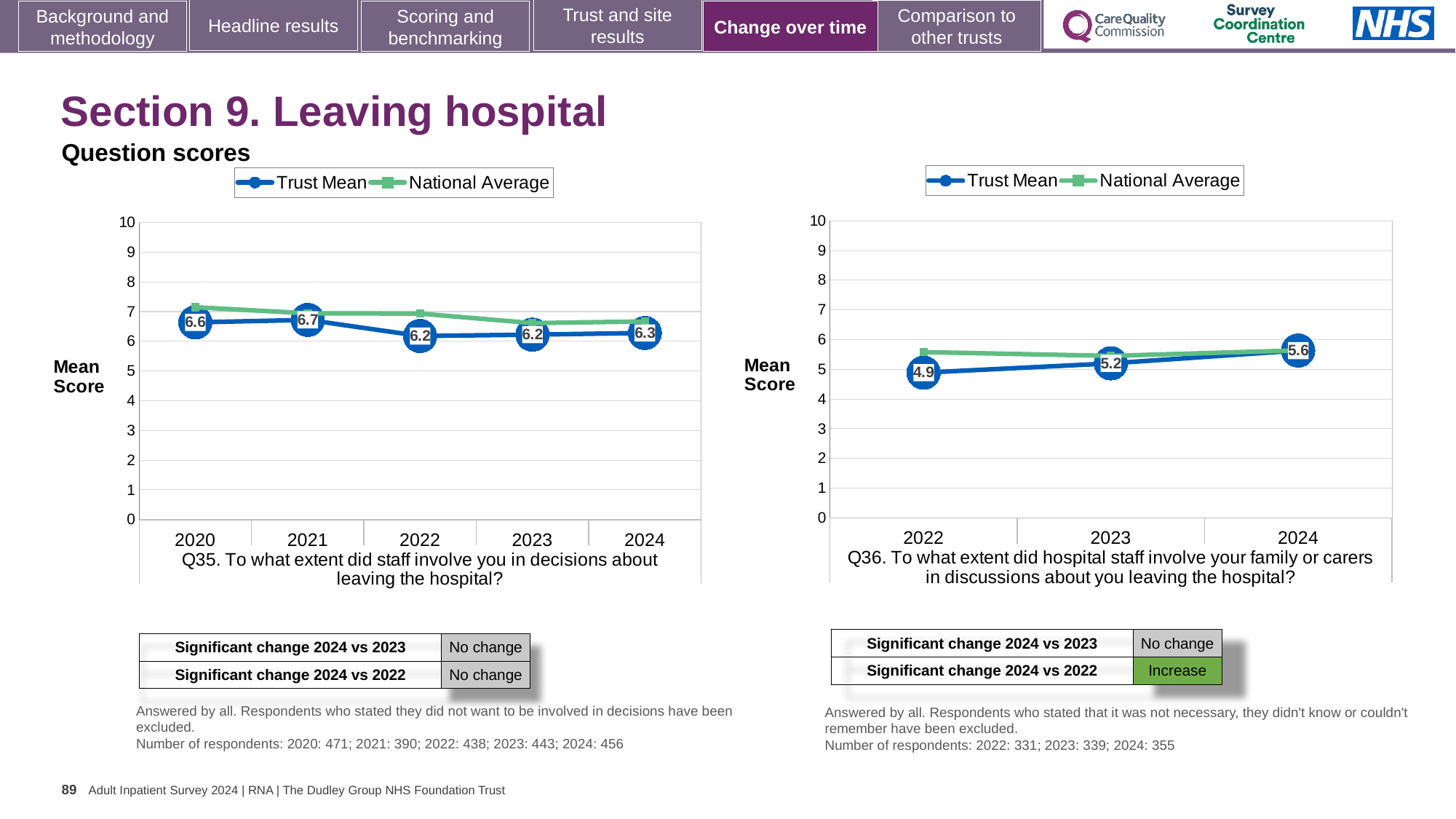
In the Q35 chart on the left, what is the Trust Mean score for 2021? 6.7 In the Q35 chart on the left, what is the Trust Mean score for 2024? 6.3 How many series does the legend of the Q35 chart on the left list? 2 In the Q35 chart on the left, is the National Average for 2020 greater or less than 7? greater In the Q35 chart on the left, what is the difference between the Trust Mean scores for 2021 and 2022? 0.5 What kind of chart is the Q36 chart on the right? Line chart In the Q36 chart on the right, what is the difference between the Trust Mean scores for 2024 and 2022? 0.7 In the Q35 chart on the left, which year has the highest Trust Mean score? 2021 In the Q36 chart on the right, what is the Trust Mean score for 2022? 4.9 In the Q36 chart on the right, what is the Trust Mean score for 2024? 5.6 How many years are plotted on the x axis of the Q36 chart on the right? 3 In the Q36 chart on the right, which year has the lowest Trust Mean score? 2022